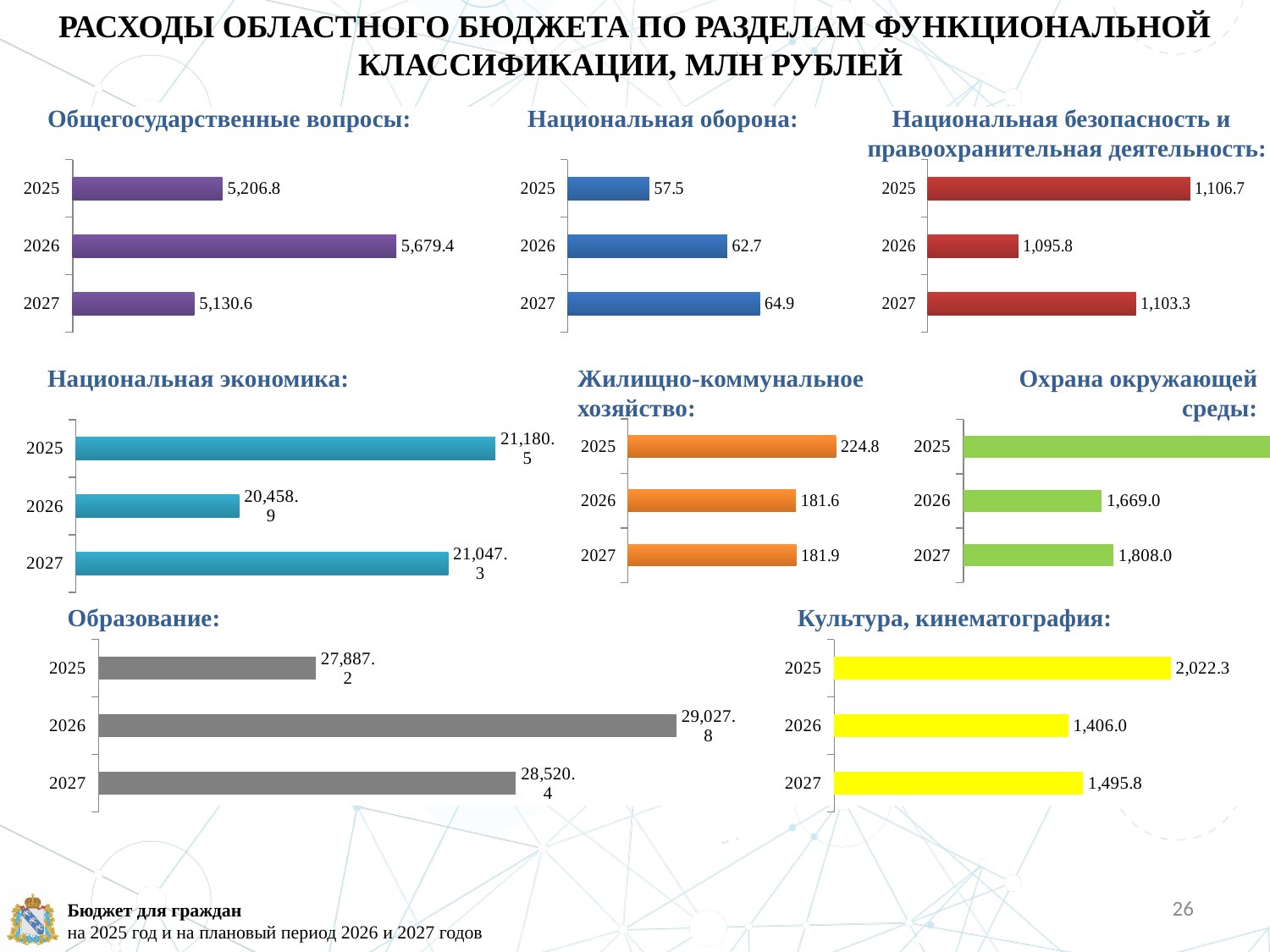
In the 'Национальная оборона' chart, which year has the lowest value? 2025 In the 'Национальная экономика' chart, which year has the highest value? 2025 In the 'Охрана окружающей среды' chart, which year has the highest value? 2025 What type of chart is used for 'Образование'? bar chart In the 'Национальная безопасность и правоохранительная деятельность' chart, what is the value for 2027? 1,103.3 In the 'Охрана окружающей среды' chart, what is the value for 2027? 1,808.0 How many charts are shown on the slide? 8 In the 'Образование' chart, which is larger, the value for 2026 or the value for 2027? 2026 In the 'Общегосударственные вопросы' chart, what is the value for 2026? 5,679.4 In the 'Жилищно-коммунальное хозяйство' chart, what is the difference between the 2025 and 2026 values? 43.2 In the 'Национальная оборона' chart, does the value rise or fall from 2025 to 2027? rise In the 'Культура, кинематография' chart, what is the value for 2025? 2,022.3